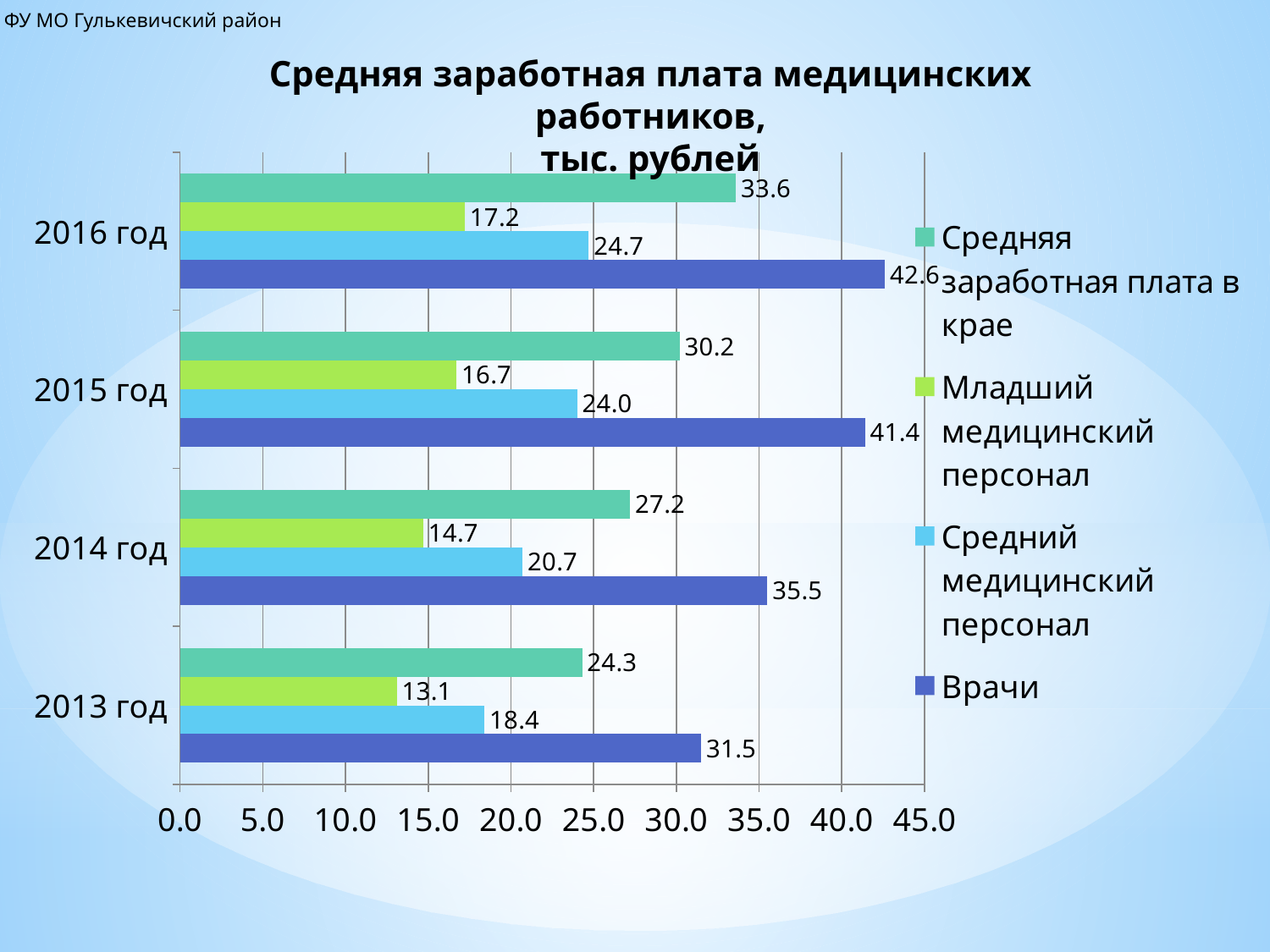
How many year categories are shown on the chart? 4 Which is larger in 2015 год: Средняя заработная плата в крае or Средний медицинский персонал? Средняя заработная плата в крае What is the value for Средний медицинский персонал in 2015 год? 24.0 What is the value for Средняя заработная плата в крае in 2014 год? 27.2 In which year is the value for Средний медицинский персонал the lowest? 2013 год What is the difference between the Врачи value in 2016 год and in 2013 год? 11.1 In which year is the value for Врачи the highest? 2016 год What is the value for Врачи in 2016 год? 42.6 How many series does the legend list? 4 What kind of chart is shown on the slide? Bar chart Do the values for Врачи rise or fall from 2013 год to 2016 год? Rise What is the value for Младший медицинский персонал in 2013 год? 13.1